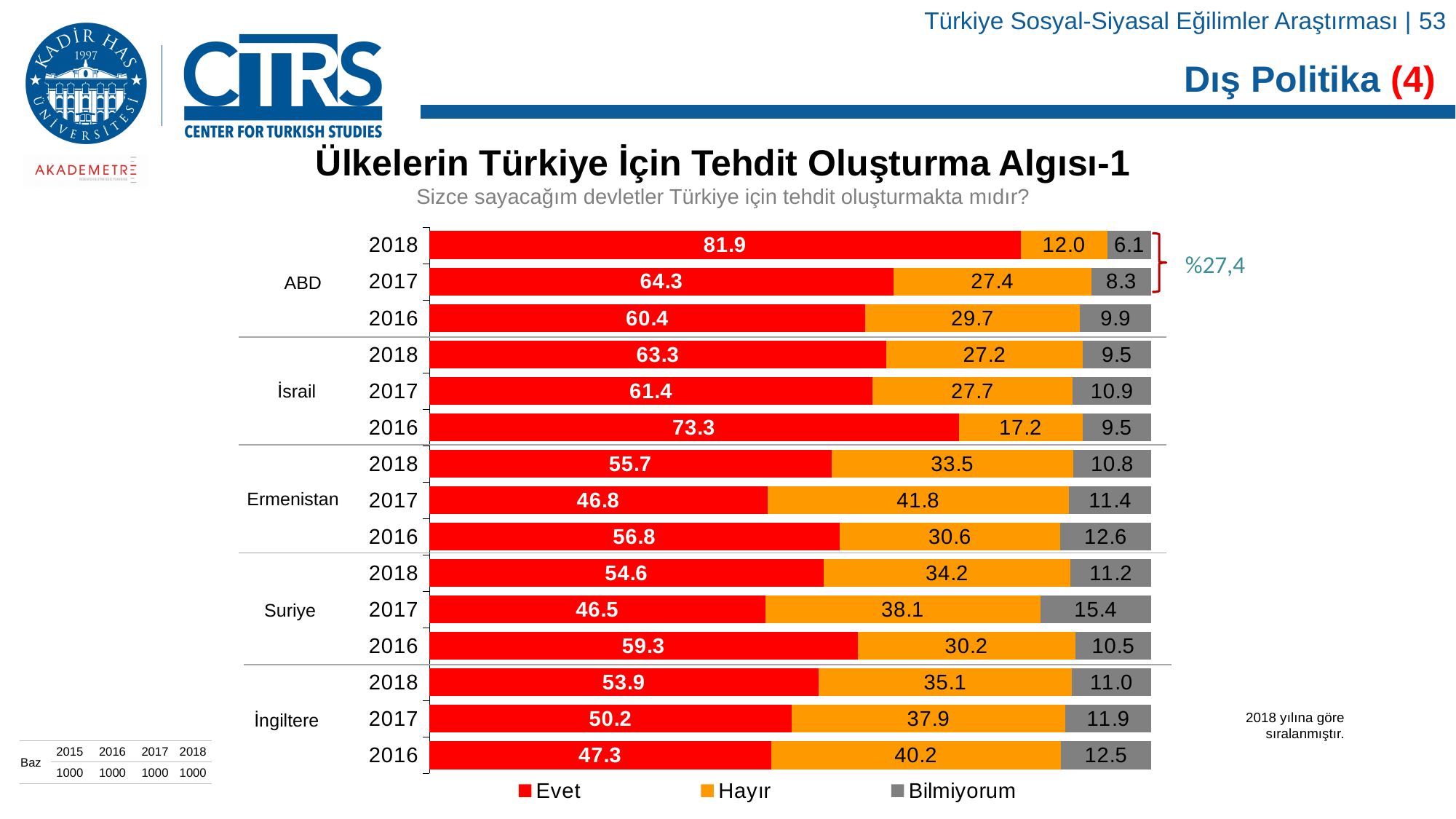
What is the difference between the Evet values for ABD in 2018 and 2017? 17.6 Which is larger, the Evet value for İsrail in 2016 or for İsrail in 2018? İsrail 2016 Which bar has the highest Evet value? ABD 2018 How many bars are plotted in the chart? 15 What are the three legend entries of the chart? Evet, Hayır, Bilmiyorum What is the Evet value for ABD in 2018? 81.9 What is the total of the stacked bar for İngiltere in 2016? 100.0 What is the Hayır value for Ermenistan in 2017? 41.8 How many series does the legend list? 3 What kind of chart is shown on the slide? Stacked bar chart Which bar has the lowest Bilmiyorum value? ABD 2018 What is the Bilmiyorum value for Suriye in 2017? 15.4